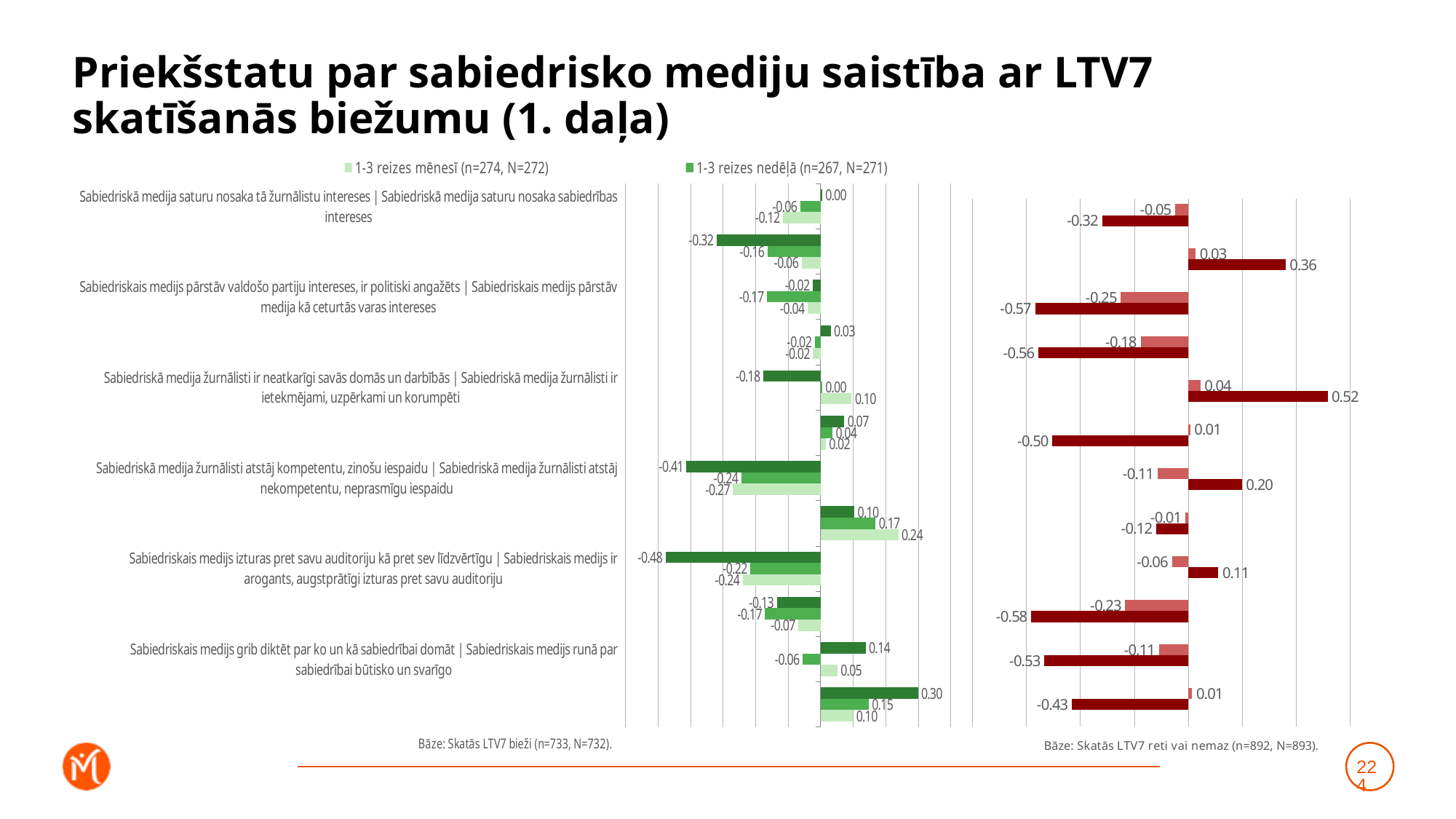
In the left-hand chart (Bāze: Skatās LTV7 bieži), what is the highest value shown? 0.30 What kind of chart is used on this slide? bar chart How many category labels are listed down the left side of the charts? 6 In the right-hand chart (Bāze: Skatās LTV7 reti vai nemaz), what is the highest value shown? 0.52 What base (Bāze) is stated under the left-hand chart? Skatās LTV7 bieži (n=733, N=732) In the right-hand chart (Bāze: Skatās LTV7 reti vai nemaz), what is the lowest value shown? -0.58 In the right-hand chart, is the lowest value greater or less than -0.50? less Which chart has the larger maximum value, the left-hand chart (Skatās LTV7 bieži) or the right-hand chart (Skatās LTV7 reti vai nemaz)? the right-hand chart In the left-hand chart (Bāze: Skatās LTV7 bieži), what is the lowest value shown? -0.48 How many series does the legend at the top of the slide list? 2 What is the first series named in the legend? 1-3 reizes mēnesī (n=274, N=272) What is the difference between the highest value in the right-hand chart (0.52) and the highest value in the left-hand chart (0.30)? 0.22